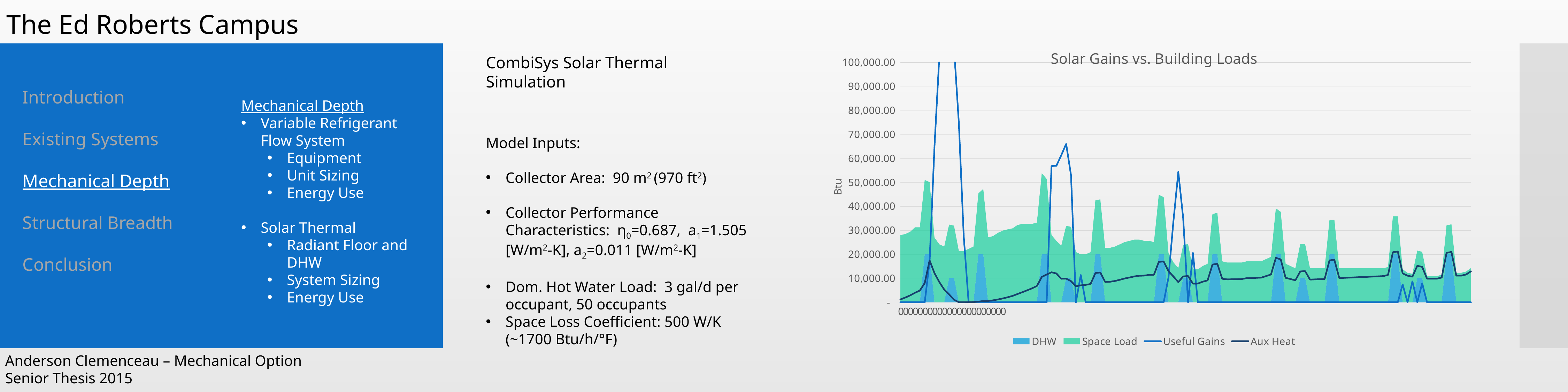
How many series does the chart legend list? 4 What is the title of the chart on the slide? Solar Gains vs. Building Loads What is the highest tick value shown on the vertical axis of the chart? 100,000.00 What label is shown on the vertical axis of the chart? Btu Does the Space Load area generally rise or fall from left to right across the chart? fall Is the peak value of the Useful Gains series greater or less than 90,000.00? greater Which reaches a higher peak in the chart, Useful Gains or Space Load? Useful Gains Is the peak value of the Aux Heat series greater or less than 30,000.00? less Is the peak value of the DHW series greater or less than 30,000.00? less Which series in the chart is drawn as a green filled area? Space Load Which series in the chart reaches the highest value? Useful Gains